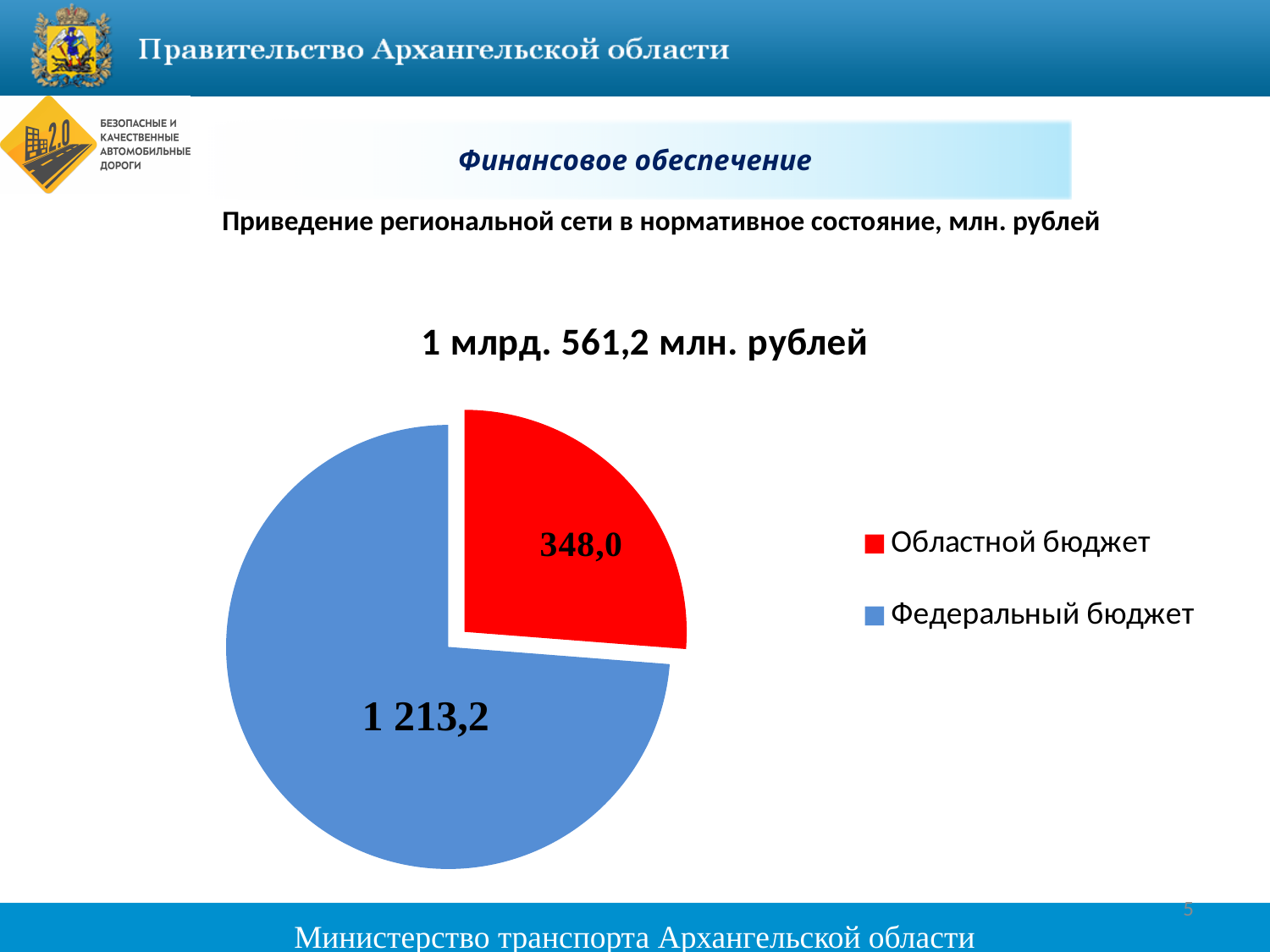
How many entries does the legend list? 2 What is the title shown above the pie chart? 1 млрд. 561,2 млн. рублей What colour is the Областной бюджет slice? red What is the total of the two slices shown in the pie chart? 1 561,2 What type of chart is shown on the slide? pie chart What is the value for Областной бюджет in the pie chart? 348,0 How many slices does the pie chart have? 2 Which is larger, Областной бюджет or Федеральный бюджет? Федеральный бюджет Which slice of the pie chart is the largest? Федеральный бюджет What is the difference between the Федеральный бюджет and Областной бюджет values? 865,2 What is the value for Федеральный бюджет in the pie chart? 1 213,2 Which slice of the pie chart is the smallest? Областной бюджет